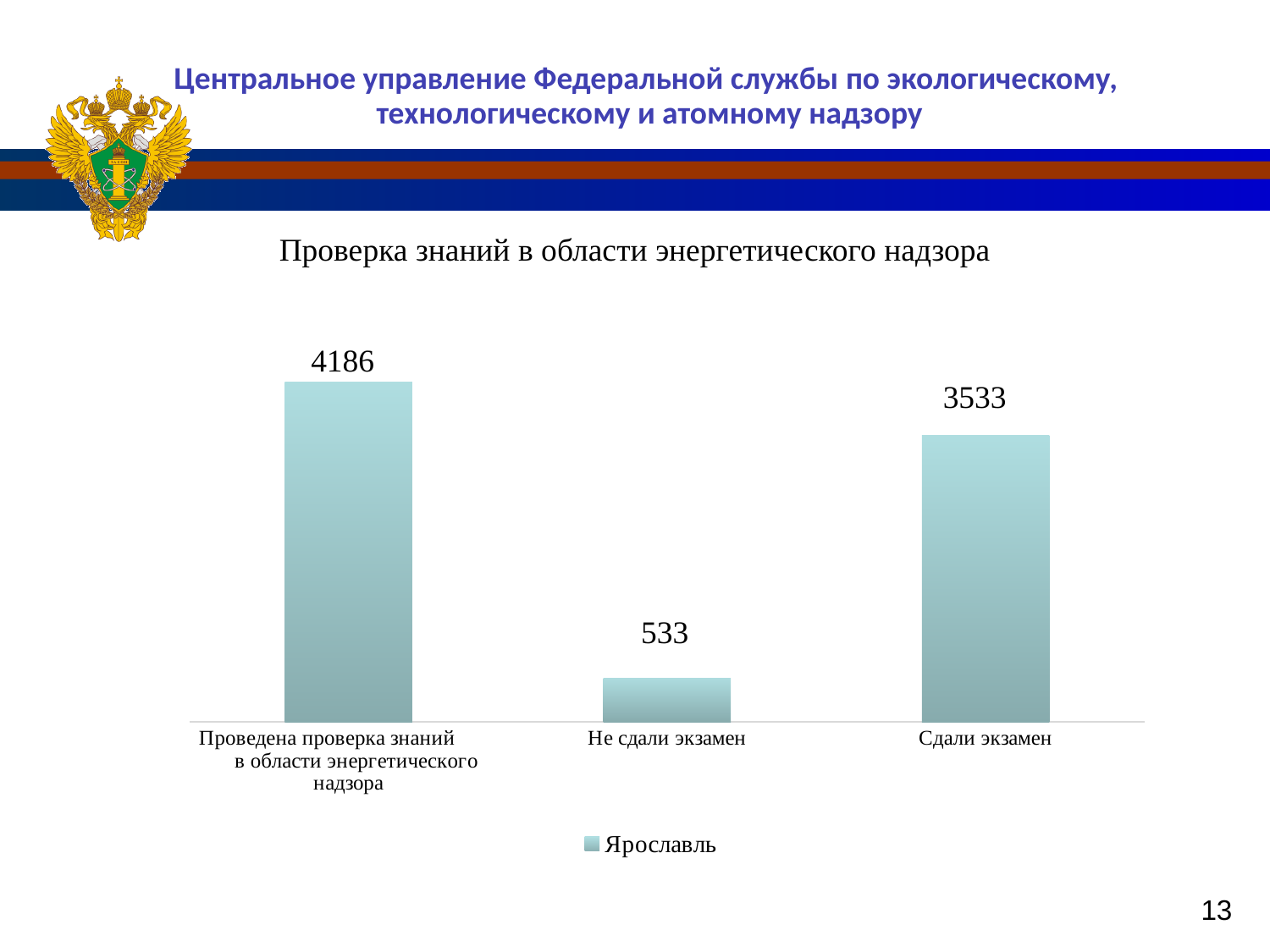
How many categories are shown in the chart? 3 What is the value for "Не сдали экзамен"? 533 Which is larger, the value for "Сдали экзамен" or the value for "Не сдали экзамен"? Сдали экзамен What is the value for "Проведена проверка знаний в области энергетического надзора"? 4186 Which category has the highest value? Проведена проверка знаний в области энергетического надзора What is the title of the chart? Проверка знаний в области энергетического надзора Which category has the lowest value? Не сдали экзамен What is the difference between the values for "Сдали экзамен" and "Не сдали экзамен"? 3000 How many series does the legend list? 1 What is the difference between the values for "Проведена проверка знаний в области энергетического надзора" and "Сдали экзамен"? 653 What kind of chart is shown on the slide? Bar chart What is the value for "Сдали экзамен"? 3533